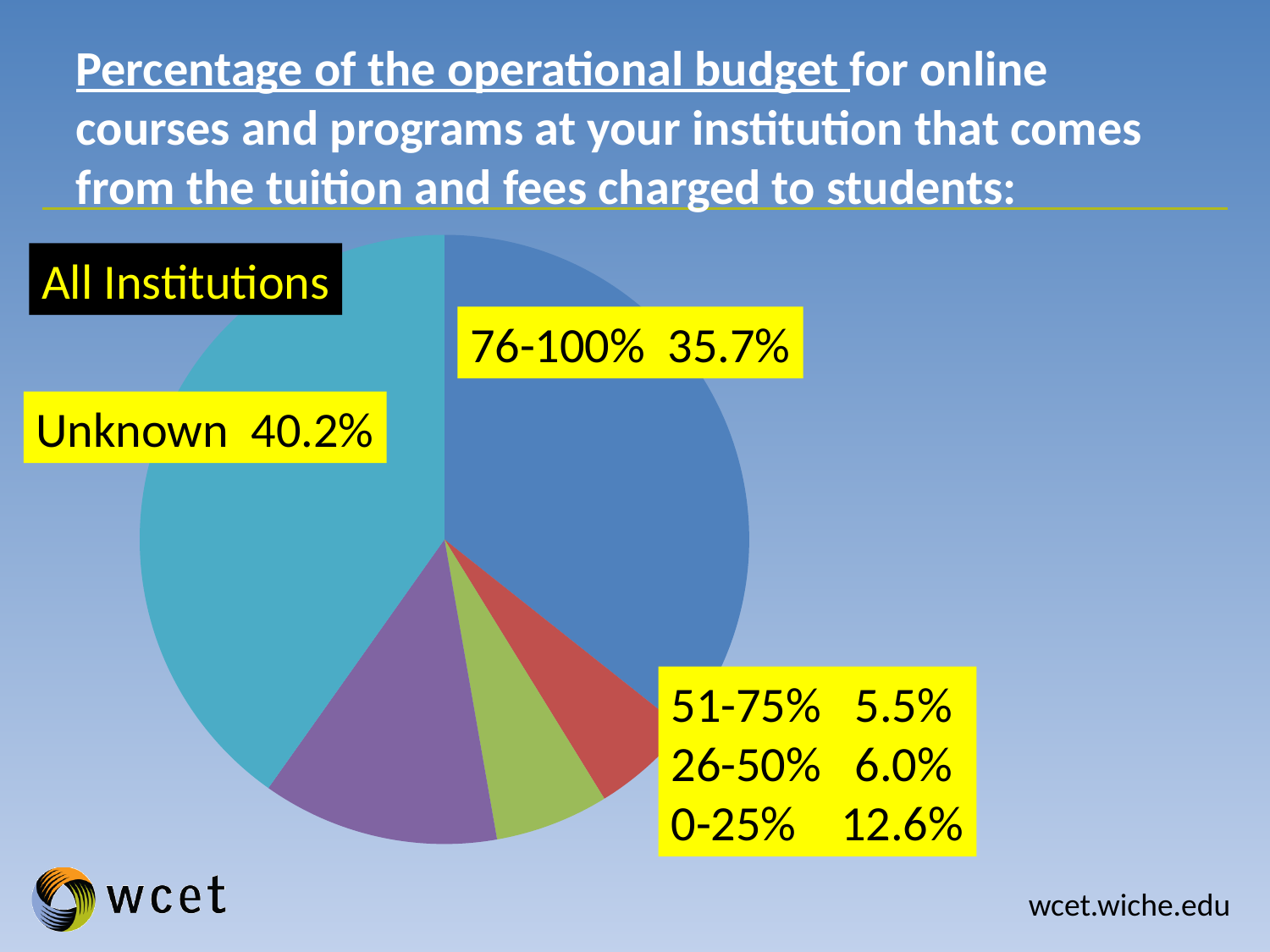
What is the difference between the Unknown share and the 76-100% share? 4.5% Which is larger, the share for 0-25% or the share for 26-50%? 0-25% What share of institutions is labelled Unknown? 40.2% What kind of chart is shown on the slide? pie chart What share of institutions reported 51-75%? 5.5% Which category has the smallest slice of the pie? 51-75% How many slices does the pie chart have? 5 What share of institutions reported 0-25%? 12.6% Which group of institutions does the pie chart represent, according to the label at the top left? All Institutions Which category has the largest slice of the pie? Unknown What share of institutions reported that 76-100% of the operational budget comes from tuition and fees? 35.7% What share of institutions reported 26-50%? 6.0%